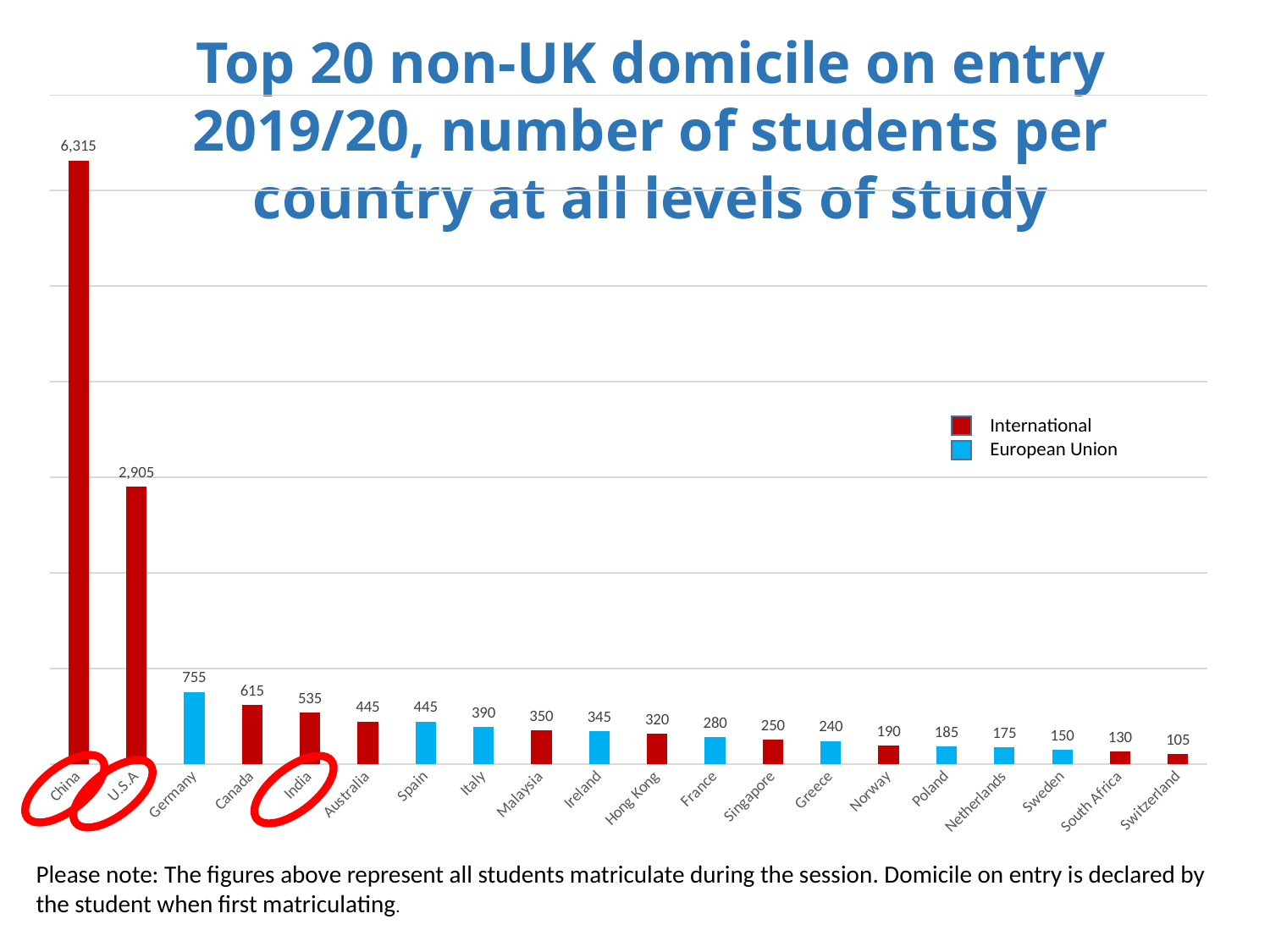
Which colour represents the European Union series in the legend? Blue What is the value for Germany? 755 How many students are shown for China? 6,315 What is the difference between the values for China and U.S.A? 3,410 How many series does the legend list? 2 What is the difference between the values for Canada and India? 80 What is the value for Hong Kong? 320 What kind of chart is shown on the slide? Bar chart Which is larger, the value for Italy or the value for Malaysia? Italy How many countries are shown on the chart? 20 Which country has the highest number of students? China Which country has the lowest number of students? Switzerland